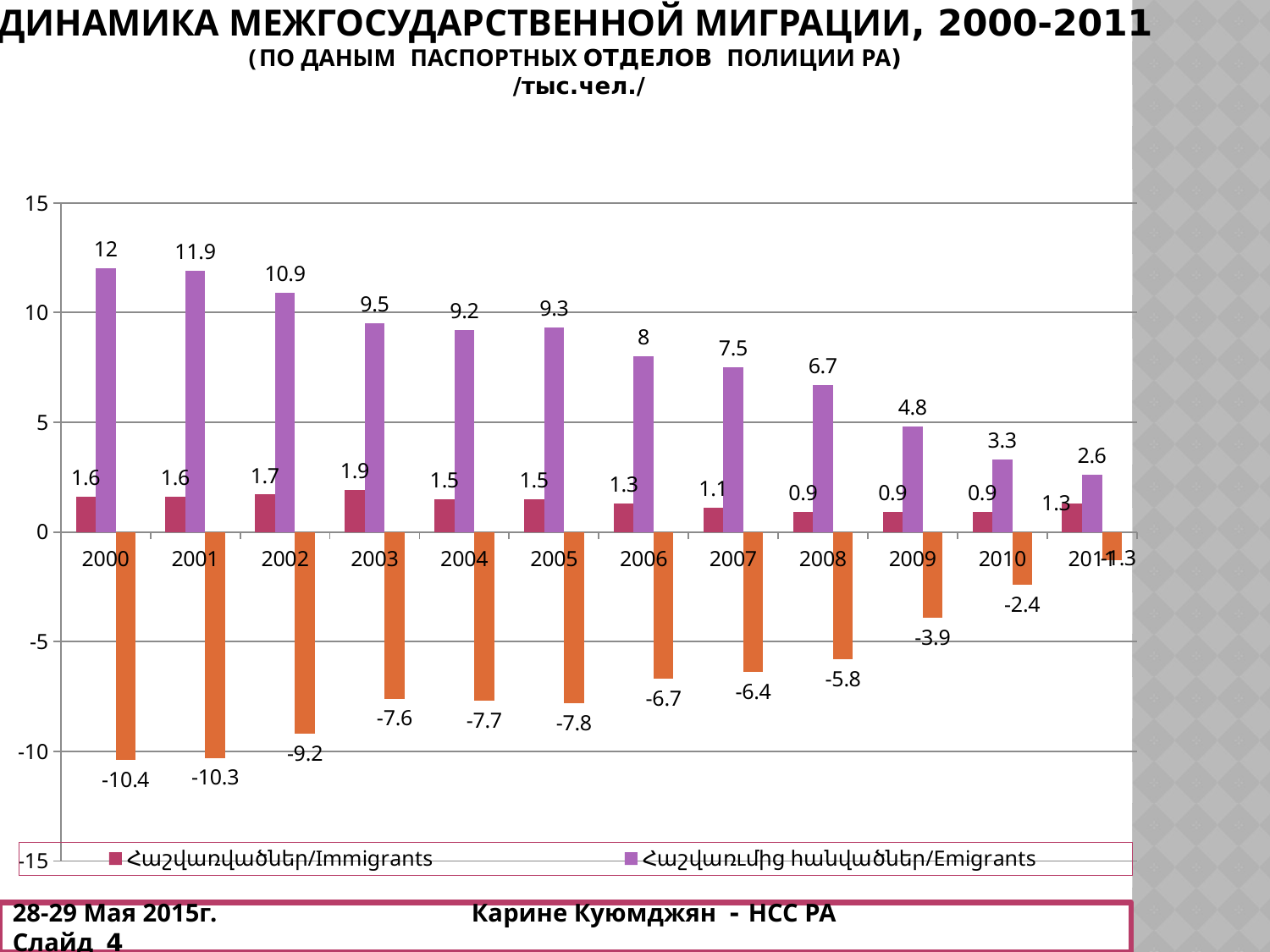
In which year is the Emigrants value highest? 2000 What is the value of the orange bar for 2009? -3.9 What is the value for Immigrants in 2003? 1.9 What is the difference between the Emigrants values for 2000 and 2011? 9.4 Do the Emigrants values rise or fall from 2000 to 2011? fall In which year is the Emigrants value lowest? 2011 How many series does the legend list? 2 What is the value for Emigrants in 2000? 12 How many years are shown on the x axis? 12 Which is larger, the Emigrants value for 2005 or for 2004? 2005 What kind of chart is shown on the slide? bar chart Is the Emigrants value for 2002 greater or less than 10? greater